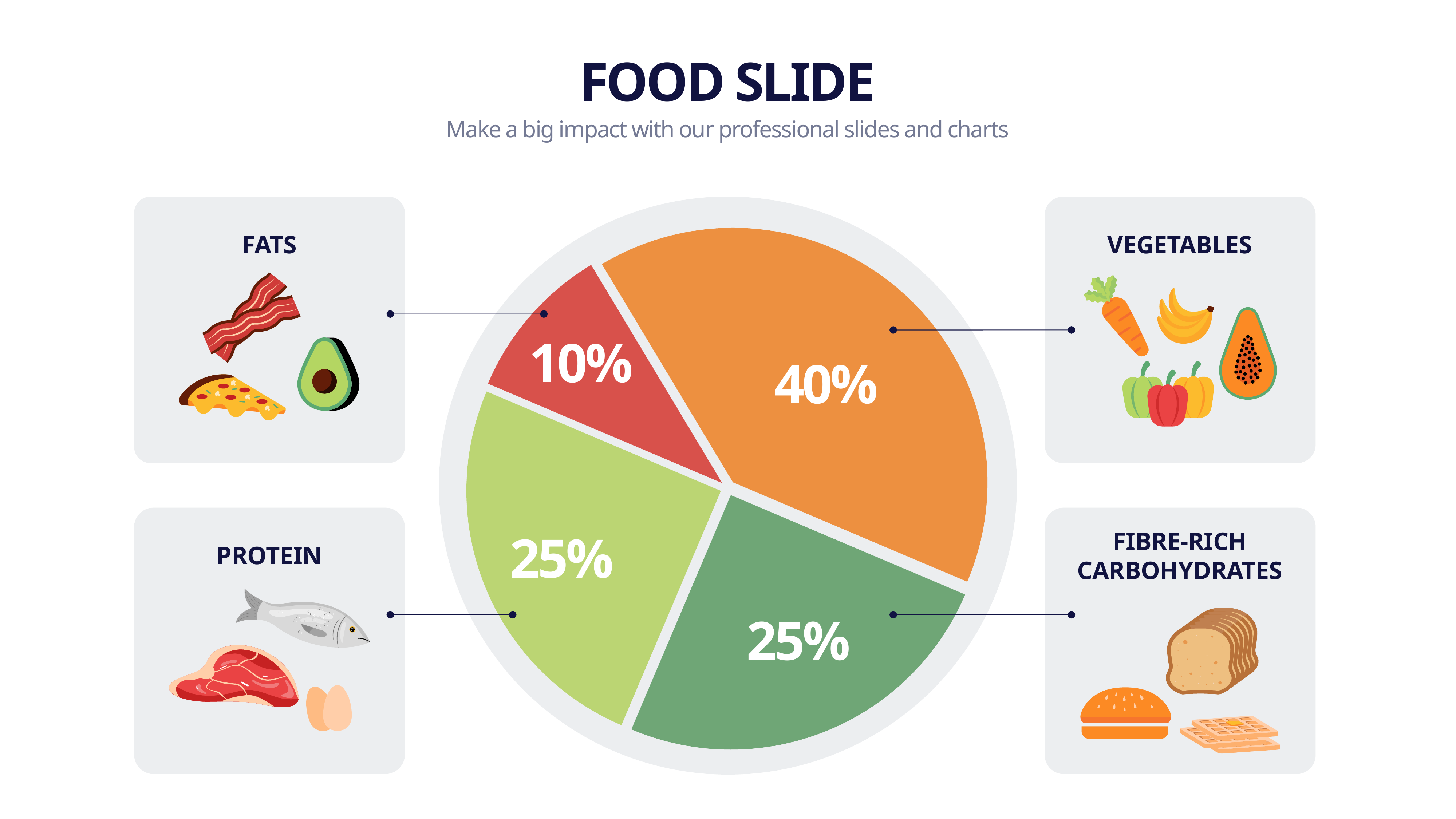
How many categories are shown in the pie chart? 4 Which is larger, the share for Protein or the share for Fats? Protein What percentage of the pie chart is Protein? 25% What is the difference in percentage points between Vegetables and Protein? 15 What percentage of the pie chart is Fats? 10% What colour is the Vegetables slice of the pie chart? Orange Which category has the smallest share of the pie chart? Fats What percentage of the pie chart is Fibre-Rich Carbohydrates? 25% Which category has the largest share of the pie chart? Vegetables What percentage of the pie chart is Vegetables? 40% What kind of chart is shown on the slide? Pie chart What is the difference in percentage points between Vegetables and Fats? 30